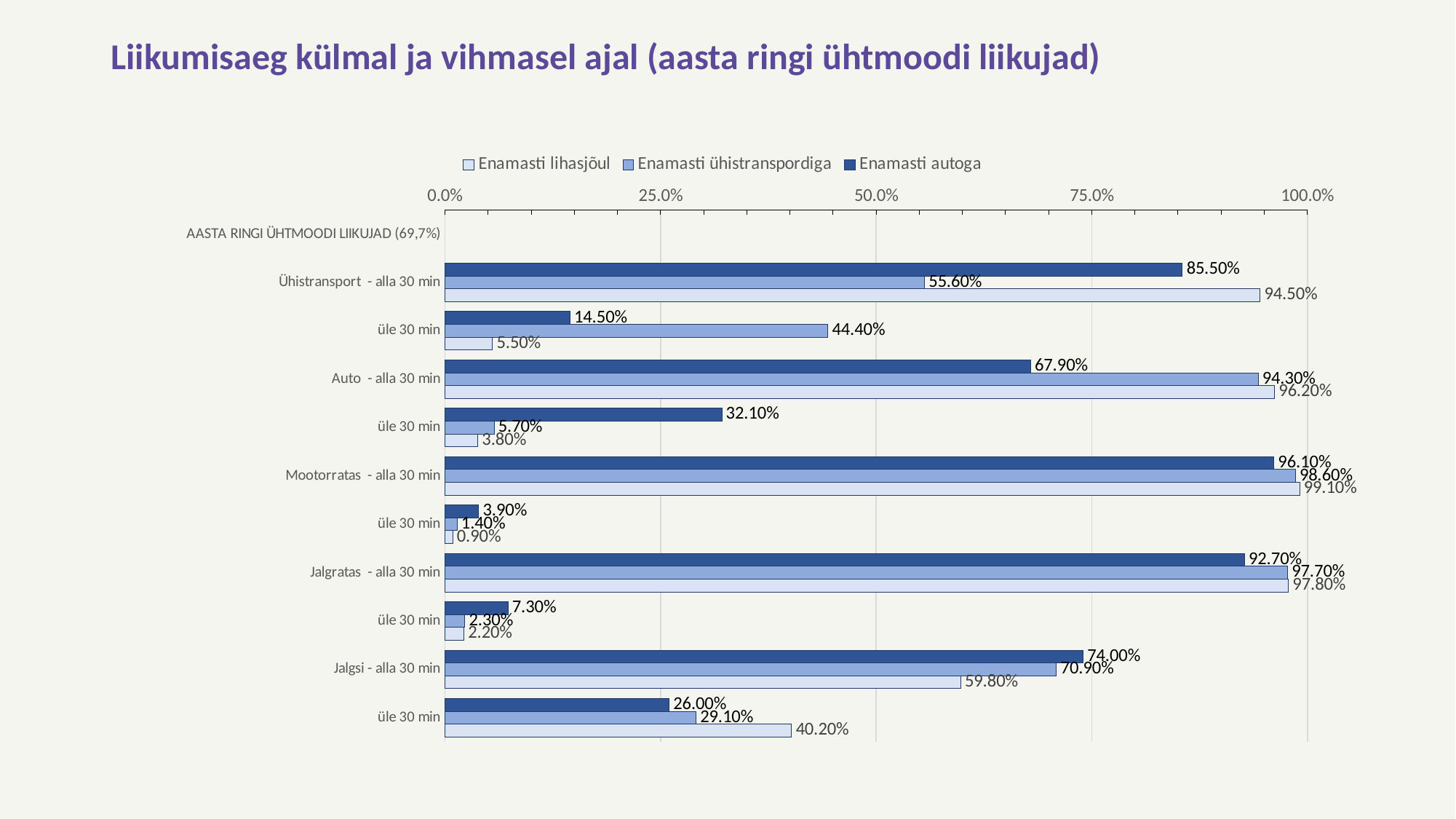
Which category has the lowest value for the Enamasti autoga series? üle 30 min (Mootorratas) Which category has the highest value for the Enamasti lihasjõul series? Mootorratas - alla 30 min Is the Enamasti autoga value for 'Auto - alla 30 min' greater or less than 50.0%? greater How many series does the legend list? 3 In the 'Jalgsi - alla 30 min' category, which is larger: the Enamasti autoga value or the Enamasti lihasjõul value? Enamasti autoga What type of chart is shown on the slide? bar chart What is the difference between the Enamasti autoga and Enamasti ühistranspordiga values in the 'Ühistransport - alla 30 min' category? 29.90% What is the value for Enamasti lihasjõul in the 'üle 30 min' category under Jalgsi? 40.20% What is the value for Enamasti autoga in the 'Ühistransport - alla 30 min' category? 85.50% What is the title of the chart on the slide? Liikumisaeg külmal ja vihmasel ajal (aasta ringi ühtmoodi liikujad) What is the value for Enamasti lihasjõul in the 'Auto - alla 30 min' category? 96.20% What is the value for Enamasti ühistranspordiga in the 'üle 30 min' category under Ühistransport? 44.40%